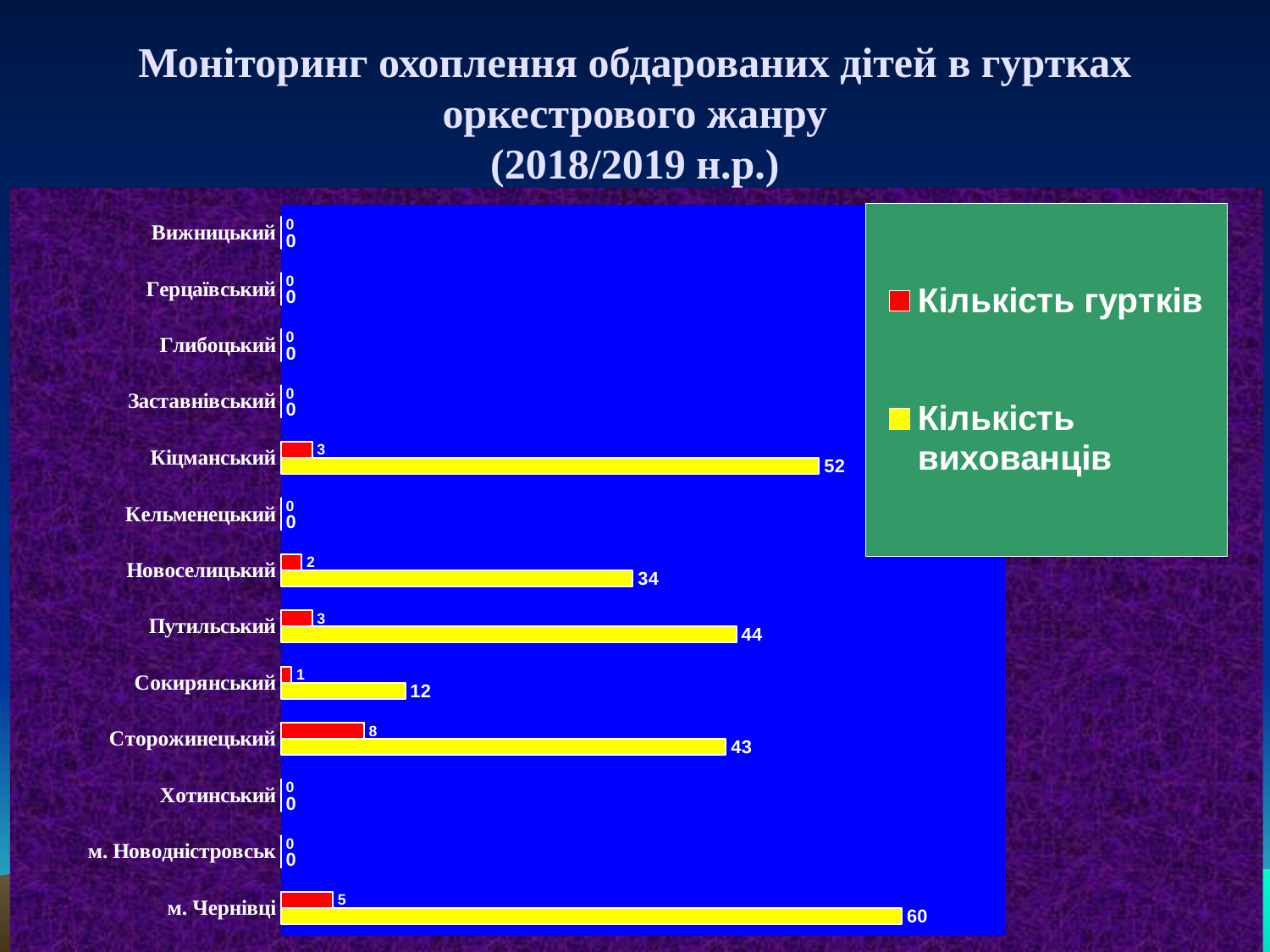
Which is larger: Кількість вихованців for Новоселицький or for Путильський? Путильський How many categories are shown on the chart? 13 What is the value of Кількість вихованців for Кіцманський? 52 Among categories with a non-zero value, which has the lowest Кількість вихованців? Сокирянський What kind of chart is shown on the slide? Bar chart Which category has the highest value of Кількість гуртків? Сторожинецький Which colour represents Кількість гуртків in the legend? Red How many series does the legend list? 2 Which category has the highest value of Кількість вихованців? м. Чернівці What is the value of Кількість гуртків for Сторожинецький? 8 What is the value of Кількість вихованців for м. Чернівці? 60 What is the difference between Кількість вихованців for Путильський and Сторожинецький? 1